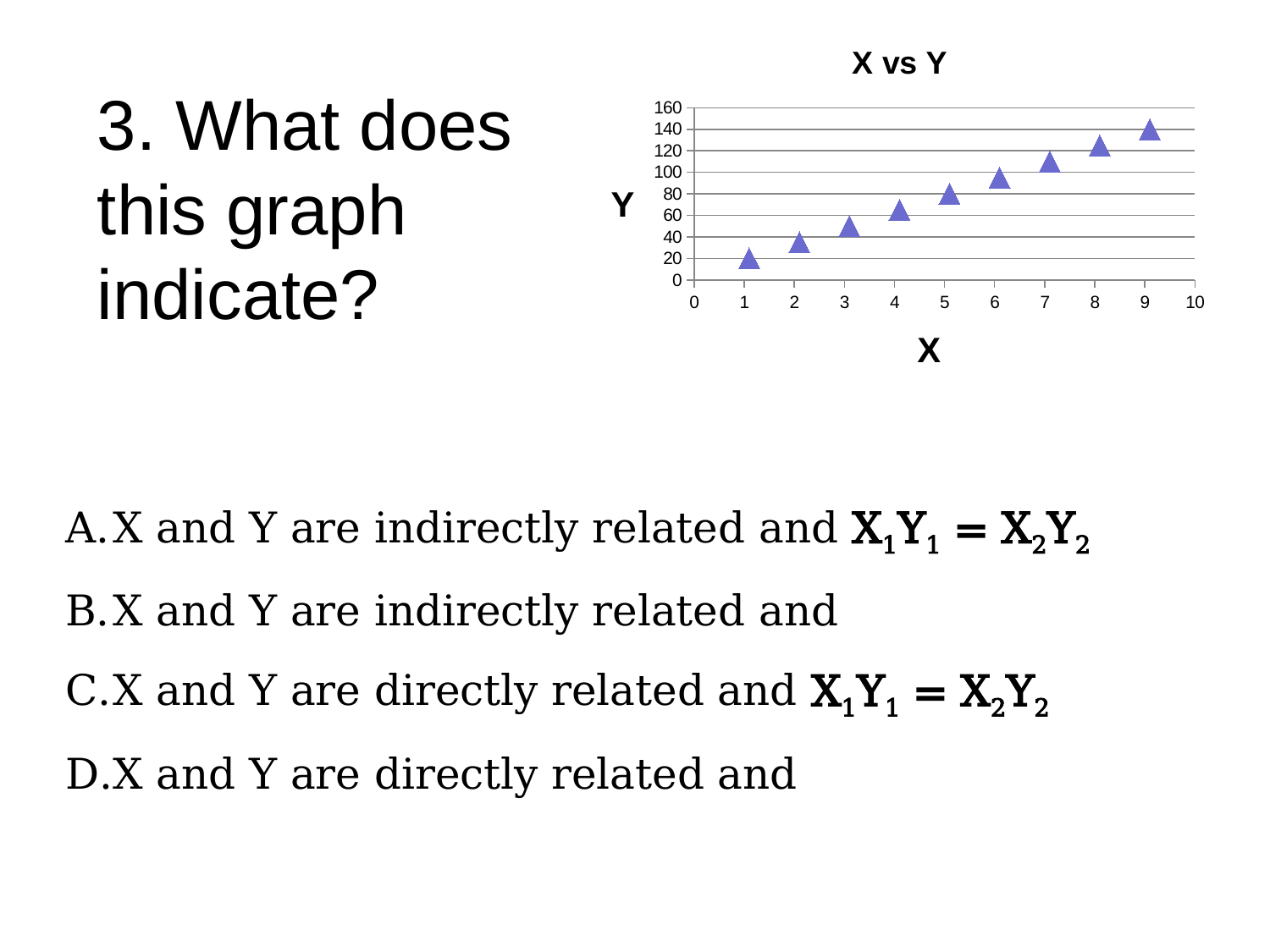
What kind of chart is shown on the slide? scatter plot Which has the larger Y value, the point at X = 7 or the point at X = 3? X = 7 Is the Y value at X = 8 greater or less than 100? greater Do the Y values rise or fall as X increases? rise Is the Y value at X = 1 greater or less than 40? less What is the label on the vertical axis of the chart? Y What is the title of the chart? X vs Y How many data points are plotted in the chart? 9 Is the Y value at X = 9 greater or less than 120? greater